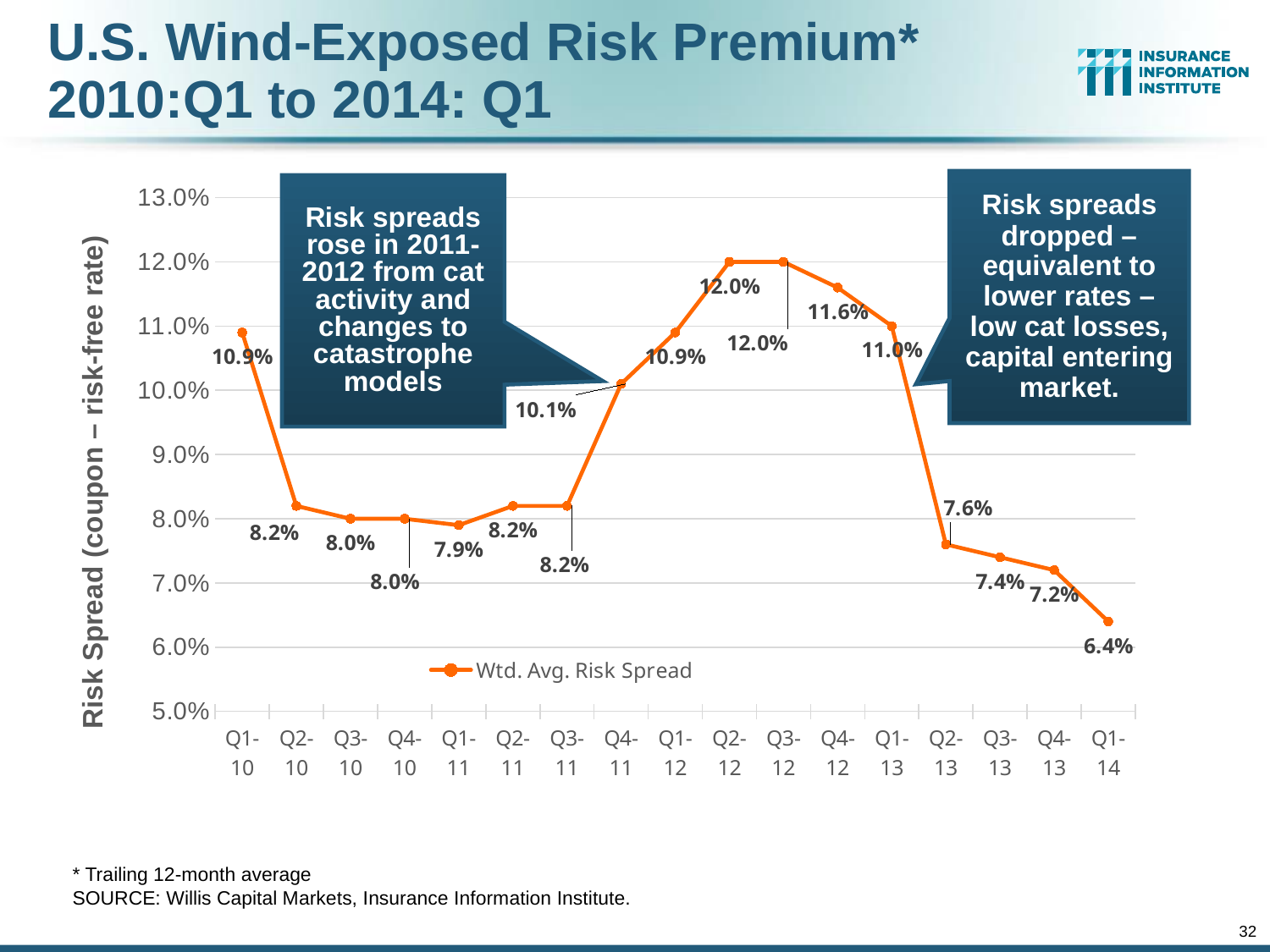
What is the weighted average risk spread for Q4-12? 11.6% What is the difference between the risk spread in Q1-13 and Q2-13? 3.4% What is the weighted average risk spread for Q1-11? 7.9% What is the weighted average risk spread for Q1-14? 6.4% How many series does the legend list? 1 Does the risk spread rise or fall from Q1-13 to Q1-14? fall Which is larger, the risk spread in Q4-11 or in Q1-12? Q1-12 What is the weighted average risk spread for Q1-10? 10.9% Which quarter has the lowest weighted average risk spread? Q1-14 What type of chart is shown on the slide? line chart What is the highest weighted average risk spread value shown on the chart? 12.0% How many quarters are plotted on the chart? 17